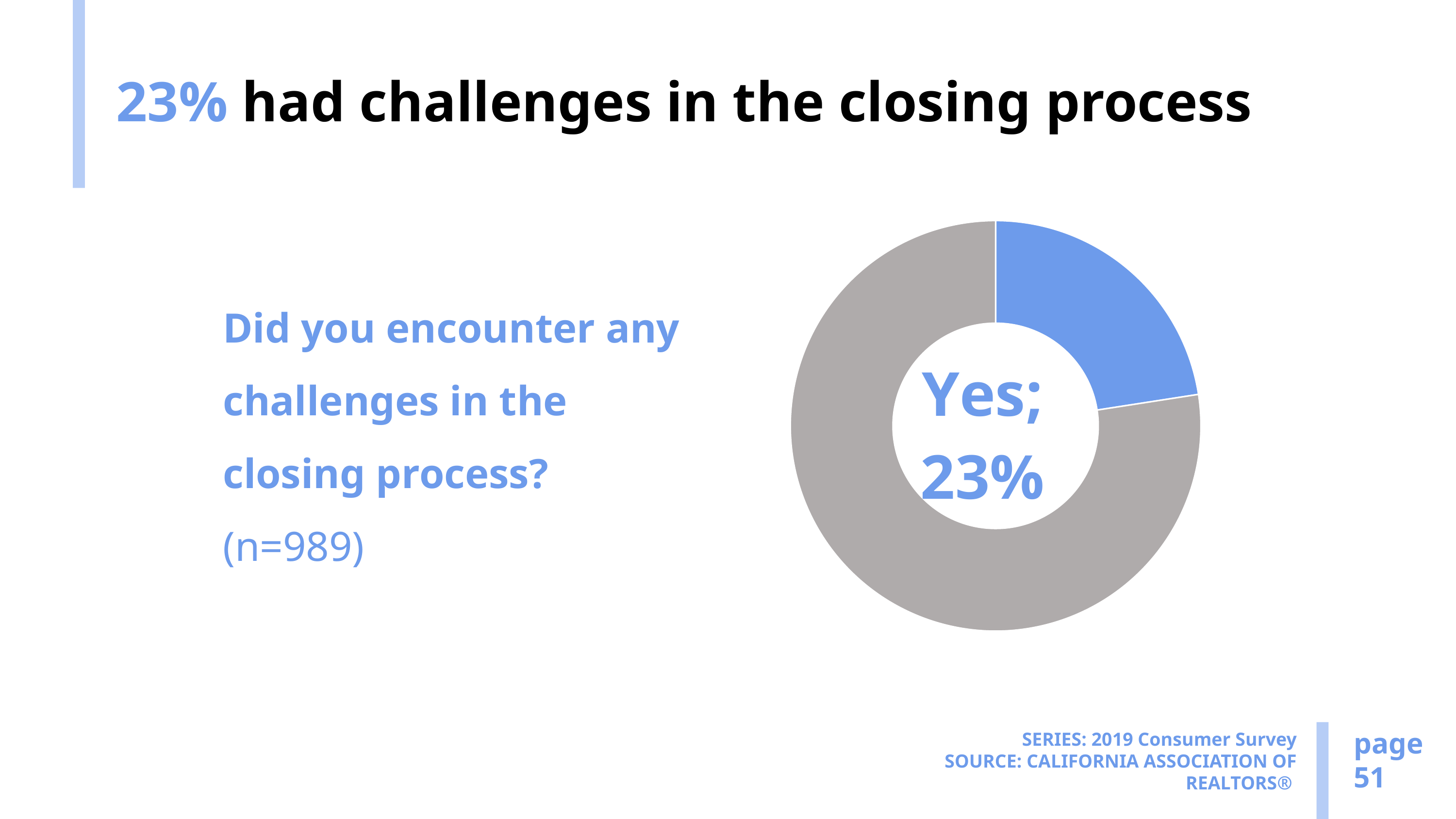
Which slice of the doughnut chart is the smallest? Yes What kind of chart is shown on the slide? Doughnut chart What survey question does the doughnut chart answer? Did you encounter any challenges in the closing process? What colour is the "Yes" slice in the doughnut chart? Blue Which slice of the doughnut chart is larger, the blue "Yes" slice or the gray slice? The gray slice What share of the doughnut chart does the "Yes" slice represent? 23% What is the sample size (n) shown for the chart? 989 How many slices does the doughnut chart have? 2 What percentage of respondents answered "Yes" in the doughnut chart? 23%